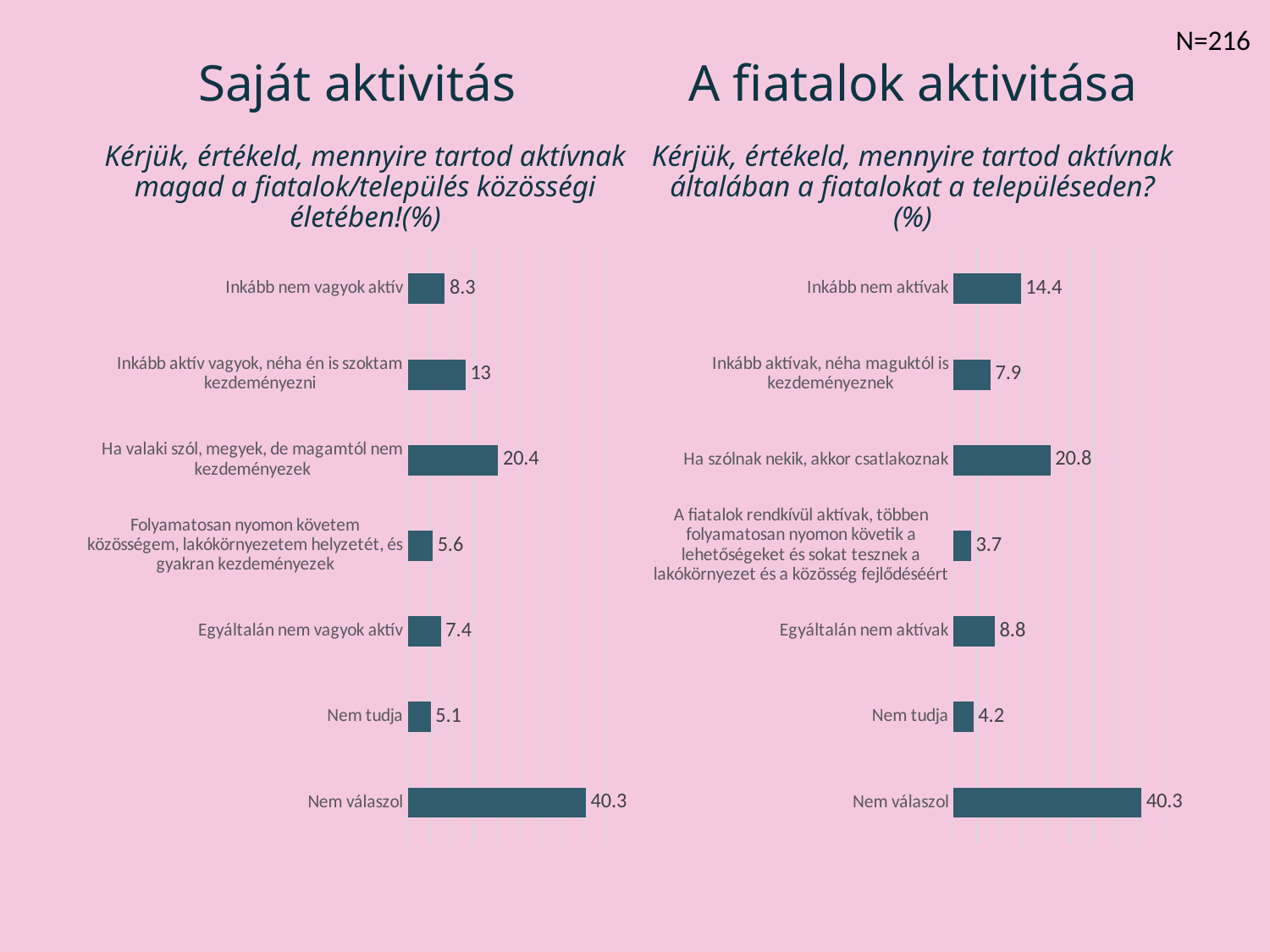
In the 'Saját aktivitás' chart, what is the difference between 'Inkább aktív vagyok, néha én is szoktam kezdeményezni' and 'Inkább nem vagyok aktív'? 4.7 How many categories does the 'Saját aktivitás' chart show? 7 What sample size (N) is shown on the slide? N=216 What kind of chart is the 'A fiatalok aktivitása' chart? Bar chart In the 'Saját aktivitás' chart, which category has the highest value? Nem válaszol In the 'A fiatalok aktivitása' chart, which is larger: 'Egyáltalán nem aktívak' or 'Nem tudja'? Egyáltalán nem aktívak In the 'Saját aktivitás' chart, what is the value for 'Ha valaki szól, megyek, de magamtól nem kezdeményezek'? 20.4 In the 'A fiatalok aktivitása' chart, what is the difference between 'Ha szólnak nekik, akkor csatlakoznak' and 'Inkább aktívak, néha maguktól is kezdeményeznek'? 12.9 In the 'Saját aktivitás' chart, which category has the lowest value? Nem tudja In the 'A fiatalok aktivitása' chart, which category has the lowest value? A fiatalok rendkívül aktívak, többen folyamatosan nyomon követik a lehetőségeket és sokat tesznek a lakókörnyezet és a közösség fejlődéséért In the 'A fiatalok aktivitása' chart, what is the value for 'Nem válaszol'? 40.3 In the 'A fiatalok aktivitása' chart, what is the value for 'Inkább nem aktívak'? 14.4